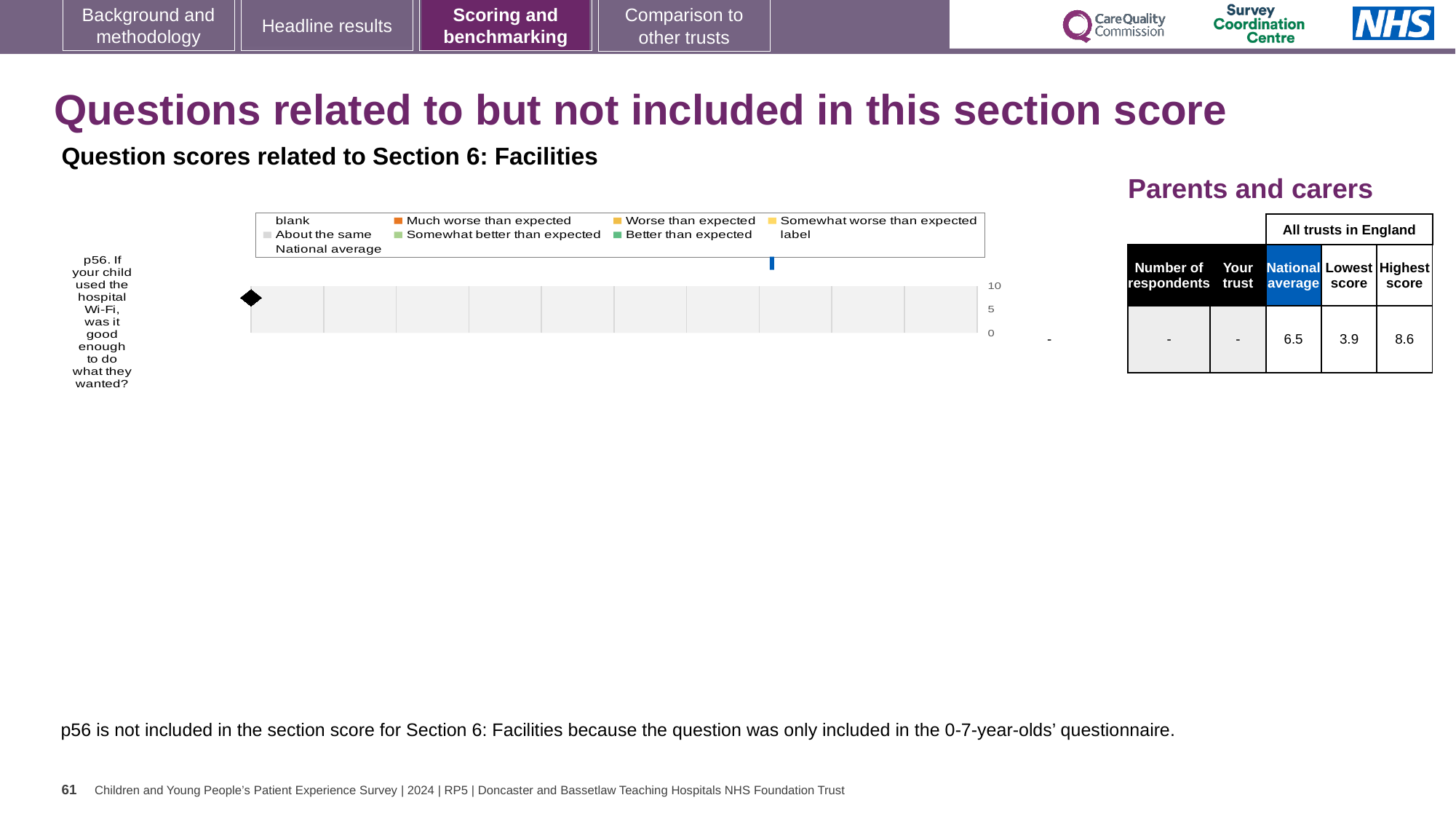
What is the difference between the highest score and the lowest score for p56 in the table? 4.7 Is the national average score for p56 greater or less than 5? greater In the table next to the chart, what is the highest score among all trusts in England for p56? 8.6 In the table next to the chart, what is shown as the score for your trust for p56? - In the table next to the chart, what is the lowest score among all trusts in England for p56? 3.9 Which is larger for p56: the national average or the lowest score? national average What kind of chart is shown for the question scores related to Section 6: Facilities? bar chart In the table next to the chart, what is the national average score for p56? 6.5 What is the highest value shown on the chart's score axis? 10 How many questions are plotted on the chart? 1 Which question is shown on the chart's category axis? p56. If your child used the hospital Wi-Fi, was it good enough to do what they wanted?